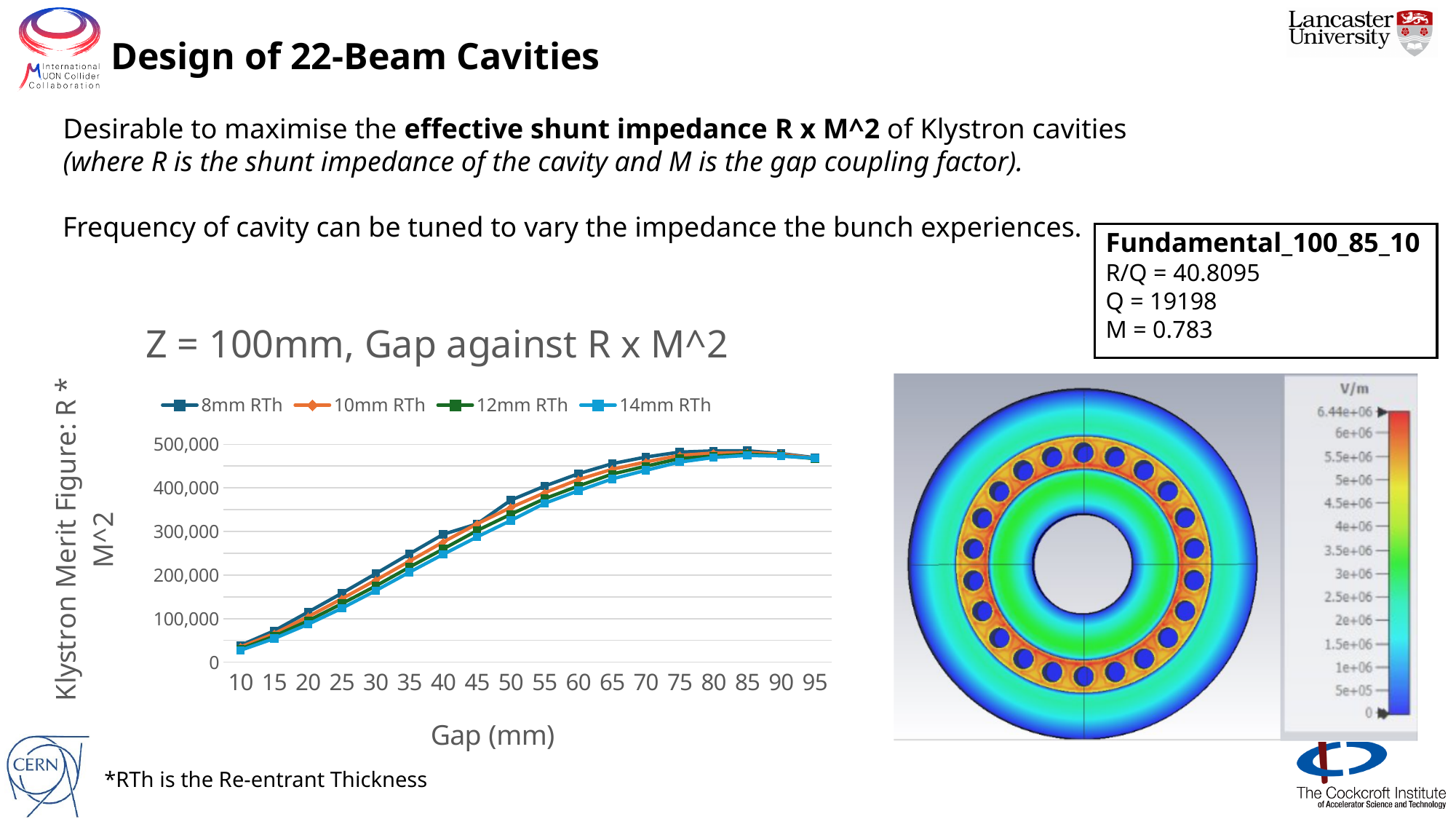
What is the title of the chart? Z = 100mm, Gap against R x M^2 At a gap of 50 mm, which series has the larger value, 8mm RTh or 14mm RTh? 8mm RTh What is the label of the x axis of the chart? Gap (mm) What kind of chart is shown on the slide? Line chart How many series does the chart legend list? 4 Is the value for 8mm RTh at a gap of 50 mm greater or less than 300,000? greater Is the value for 8mm RTh at a gap of 10 mm greater or less than 100,000? less Do the values for 8mm RTh rise or fall as the gap increases from 10 mm to 50 mm? Rise Is the value for 8mm RTh at a gap of 85 mm greater or less than 400,000? greater At which gap value is the 8mm RTh series lowest? 10 How many gap values are plotted along the x axis of the chart? 18